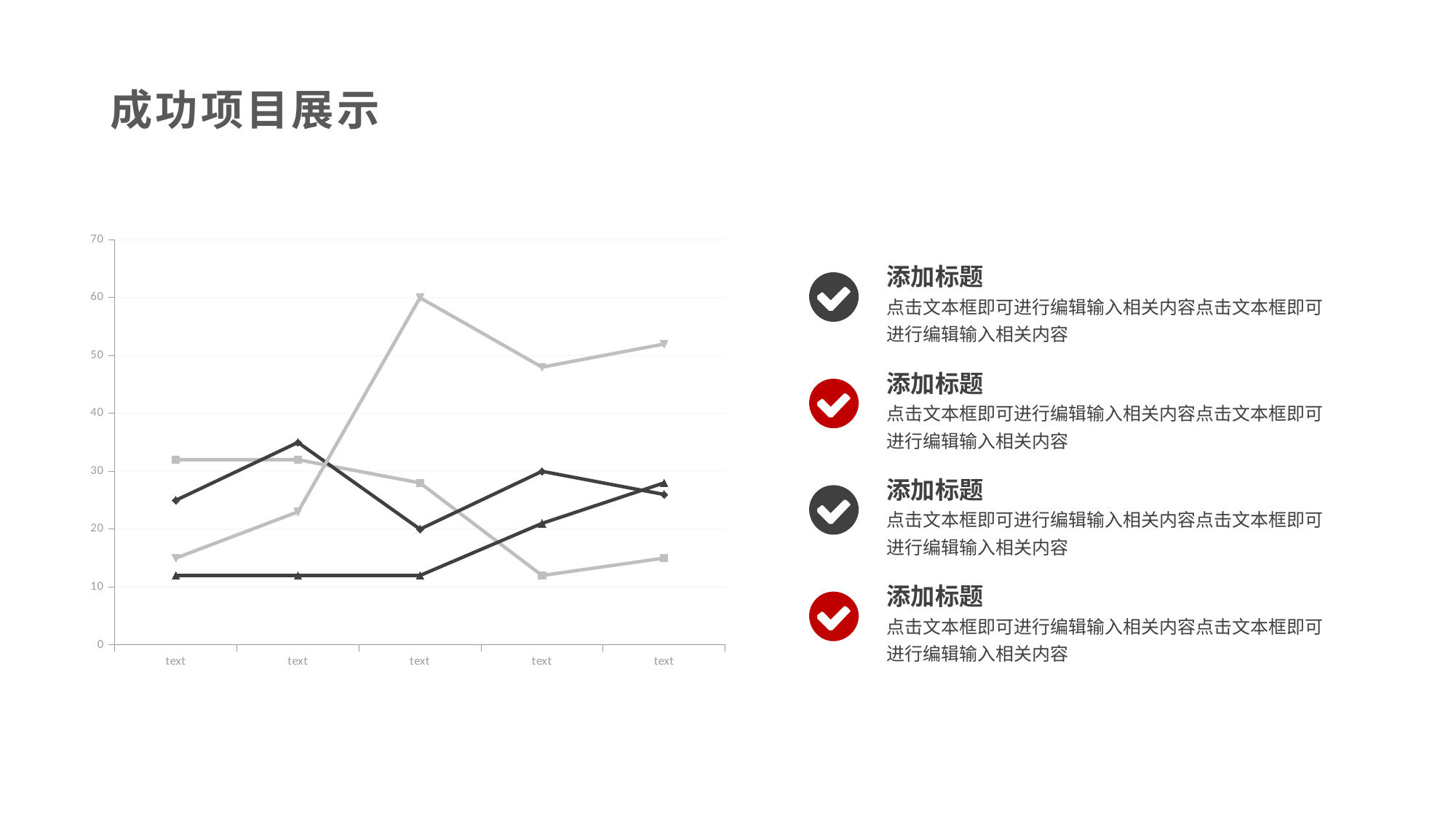
Is the value of the dark line with triangle markers at the first category greater or less than 20? less What kind of chart is shown on the slide? line chart Is the value of the dark line with diamond markers at the second category greater or less than 30? greater Which line reaches the highest value anywhere in the chart? the light grey line with inverted-triangle markers What is the highest tick value shown on the chart's y axis? 70 Is the value of the light grey line with inverted-triangle markers at the third category greater or less than 50? greater At the third category, which is higher: the light grey line with inverted-triangle markers or the dark line with diamond markers? the light grey line with inverted-triangle markers How many lines are plotted in the chart? 4 Does the dark line with triangle markers rise or fall from the first category to the last? rises How many categories are on the x axis of the chart? 5 Does the light grey line with square markers rise or fall from the first category to the last? falls